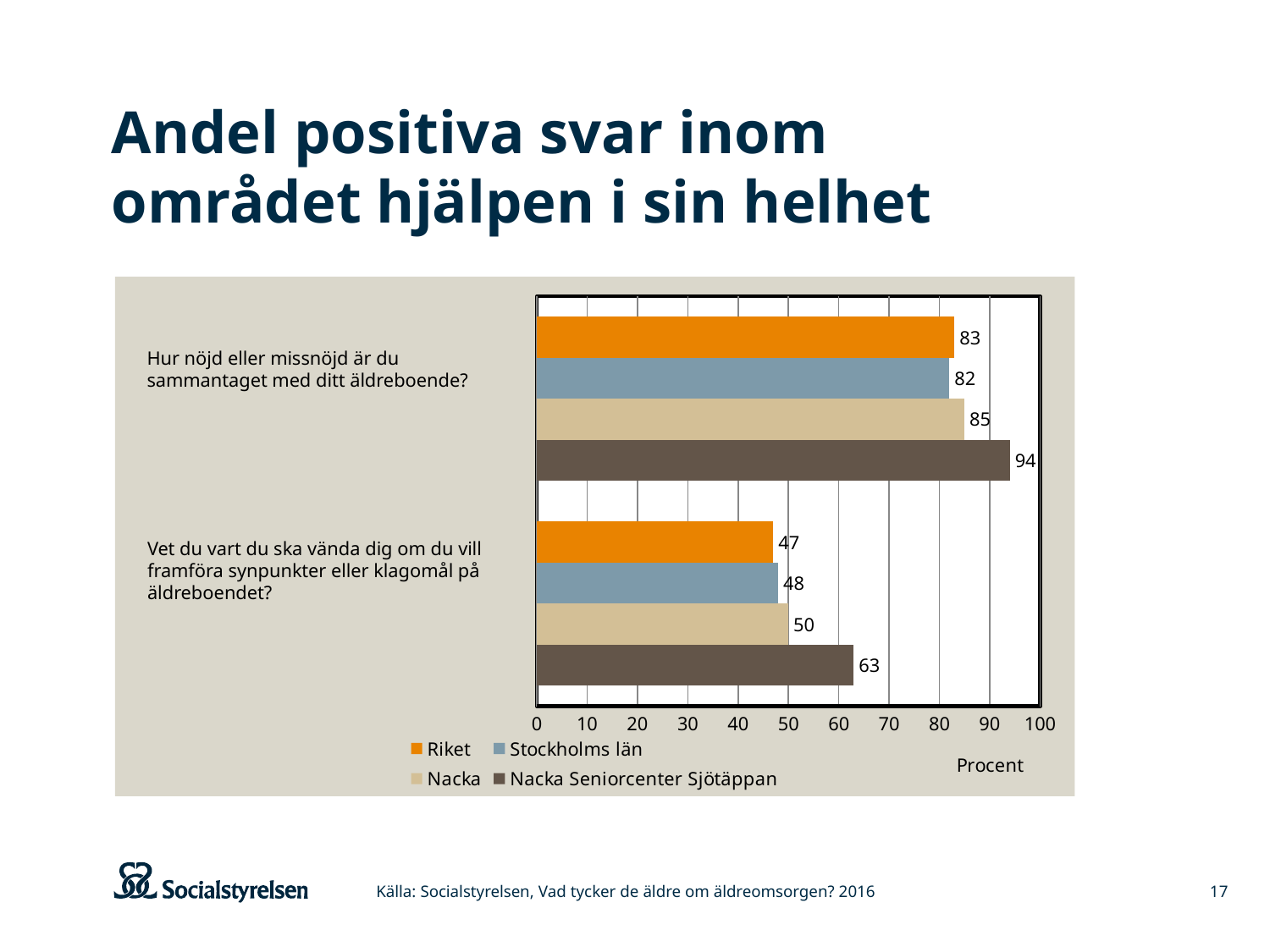
What unit is indicated on the horizontal axis of the chart? Procent How many series does the legend list? 4 What is the difference between Nacka Seniorcenter Sjötäppan and Nacka on the question "Vet du vart du ska vända dig om du vill framföra synpunkter eller klagomål på äldreboendet?"? 13 What value is shown for Riket on the question "Vet du vart du ska vända dig om du vill framföra synpunkter eller klagomål på äldreboendet?"? 47 What is the difference between Nacka Seniorcenter Sjötäppan and Riket on the question "Hur nöjd eller missnöjd är du sammantaget med ditt äldreboende?"? 11 What value is shown for Nacka Seniorcenter Sjötäppan on the question "Hur nöjd eller missnöjd är du sammantaget med ditt äldreboende?"? 94 Which series has the highest value on the question "Vet du vart du ska vända dig om du vill framföra synpunkter eller klagomål på äldreboendet?"? Nacka Seniorcenter Sjötäppan What value is shown for Nacka on the question "Vet du vart du ska vända dig om du vill framföra synpunkter eller klagomål på äldreboendet?"? 50 What value is shown for Stockholms län on the question "Hur nöjd eller missnöjd är du sammantaget med ditt äldreboende?"? 82 Which is larger: Nacka on the satisfaction question ("Hur nöjd eller missnöjd...") or Nacka on the complaints question ("Vet du vart du ska vända dig...")? Nacka on the satisfaction question What kind of chart is shown on the slide? Bar chart Which series has the lowest value on the question "Hur nöjd eller missnöjd är du sammantaget med ditt äldreboende?"? Stockholms län